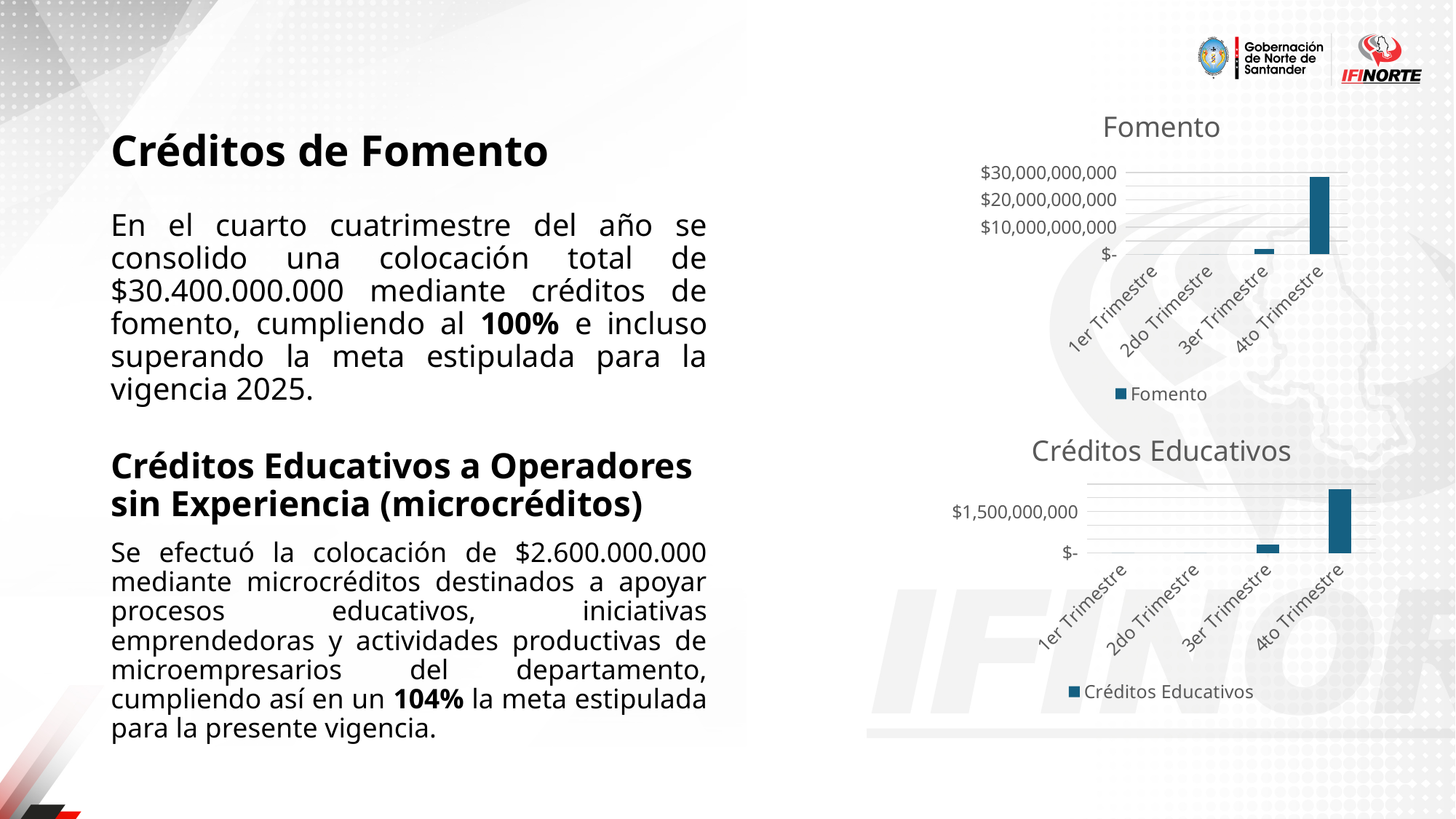
How many series does the legend of the 'Fomento' chart list? 1 In the 'Créditos Educativos' chart, do the values generally rise or fall from 1er Trimestre to 4to Trimestre? rise In the 'Fomento' chart, is the value for 4to Trimestre greater or less than $20,000,000,000? greater What kind of chart is the 'Fomento' chart? bar chart How many trimester categories are shown on the x axis of the 'Fomento' chart? 4 In the 'Fomento' chart, which trimester has the highest value? 4to Trimestre In the 'Fomento' chart, is the value for 3er Trimestre greater or less than $10,000,000,000? less In the 'Créditos Educativos' chart, which trimester has the highest value? 4to Trimestre In the 'Créditos Educativos' chart, which is larger, the value for 3er Trimestre or 4to Trimestre? 4to Trimestre What is the legend entry shown below the 'Créditos Educativos' chart? Créditos Educativos In the 'Créditos Educativos' chart, is the value for 3er Trimestre greater or less than $1,500,000,000? less